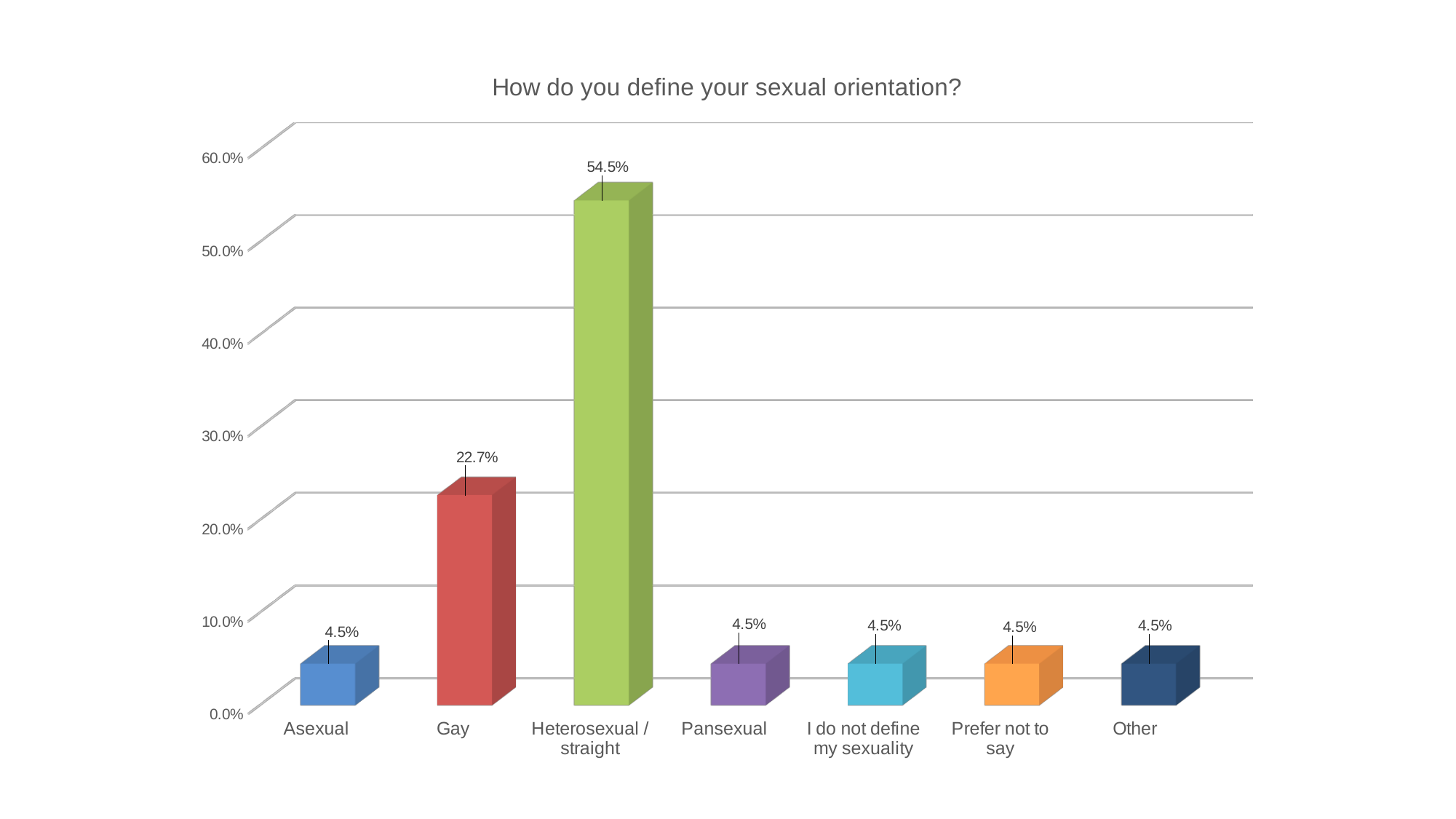
Which category has the highest value? Heterosexual / straight What is the value for Pansexual? 4.5% What is the value for Prefer not to say? 4.5% What is the title of the chart? How do you define your sexual orientation? What is the value for Heterosexual / straight? 54.5% What is the value for Gay? 22.7% Is the value for Gay greater or less than 20.0%? greater Which is larger, the value for Gay or the value for Other? Gay How many categories are shown on the x axis? 7 What is the difference between the values for Heterosexual / straight and Gay? 31.8% What kind of chart is shown on the slide? Bar chart What is the difference between the values for Gay and Asexual? 18.2%